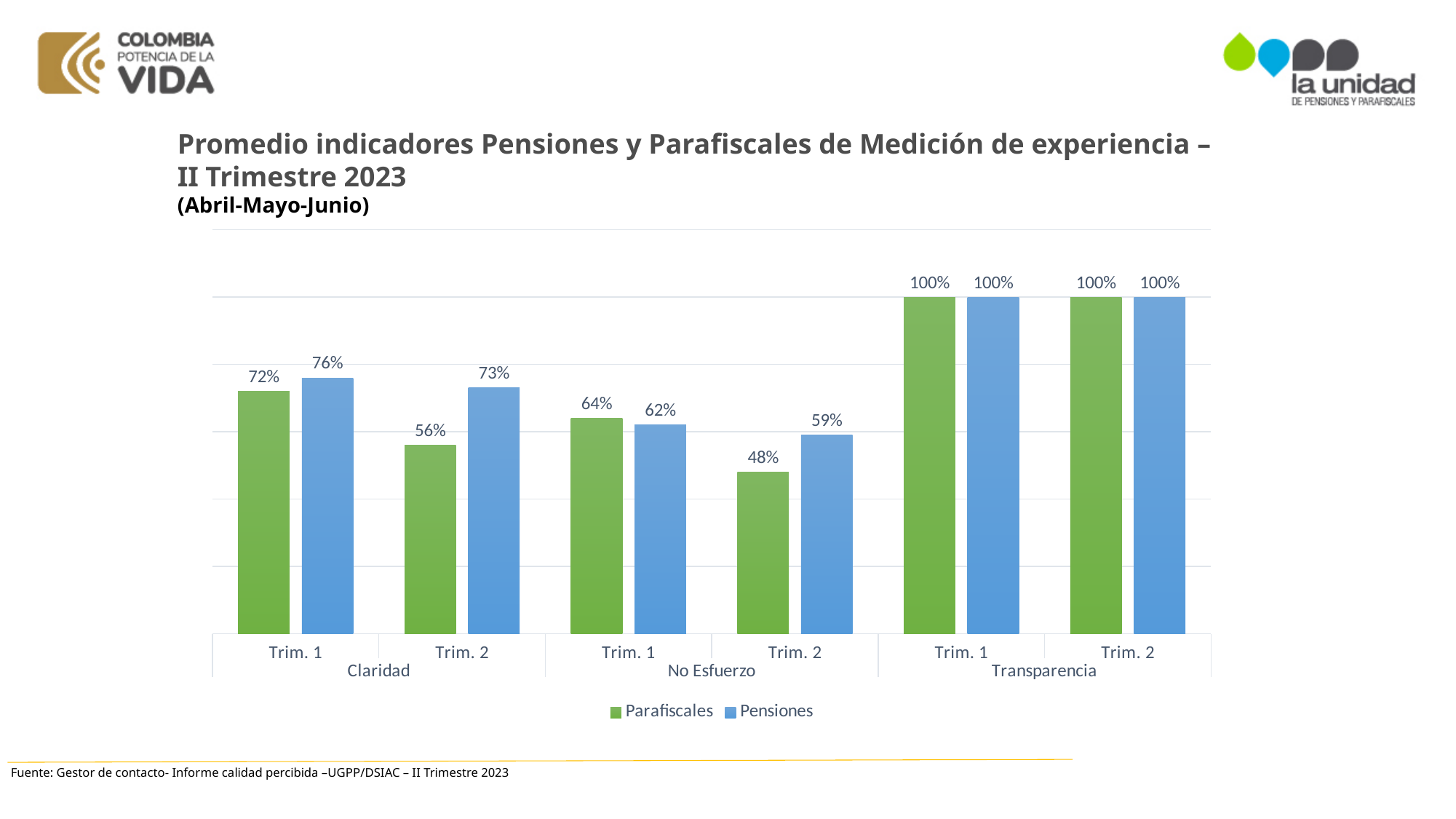
What is the difference between the Pensiones and Parafiscales values for Trim. 1 under Claridad? 4% What kind of chart is shown on the slide? Bar chart Which category and quarter has the lowest Parafiscales value? No Esfuerzo, Trim. 2 What is the difference between the Parafiscales values for Trim. 1 and Trim. 2 under No Esfuerzo? 16% What is the Parafiscales value for Trim. 1 under Claridad? 72% Which colour represents the Pensiones series in the chart? Blue How many series does the legend list? 2 For Trim. 2 under Claridad, which series has the larger value, Parafiscales or Pensiones? Pensiones What is the Pensiones value for Trim. 1 under Transparencia? 100% For Trim. 1 under No Esfuerzo, which series has the larger value, Parafiscales or Pensiones? Parafiscales What is the Parafiscales value for Trim. 2 under Claridad? 56% What is the Pensiones value for Trim. 2 under No Esfuerzo? 59%